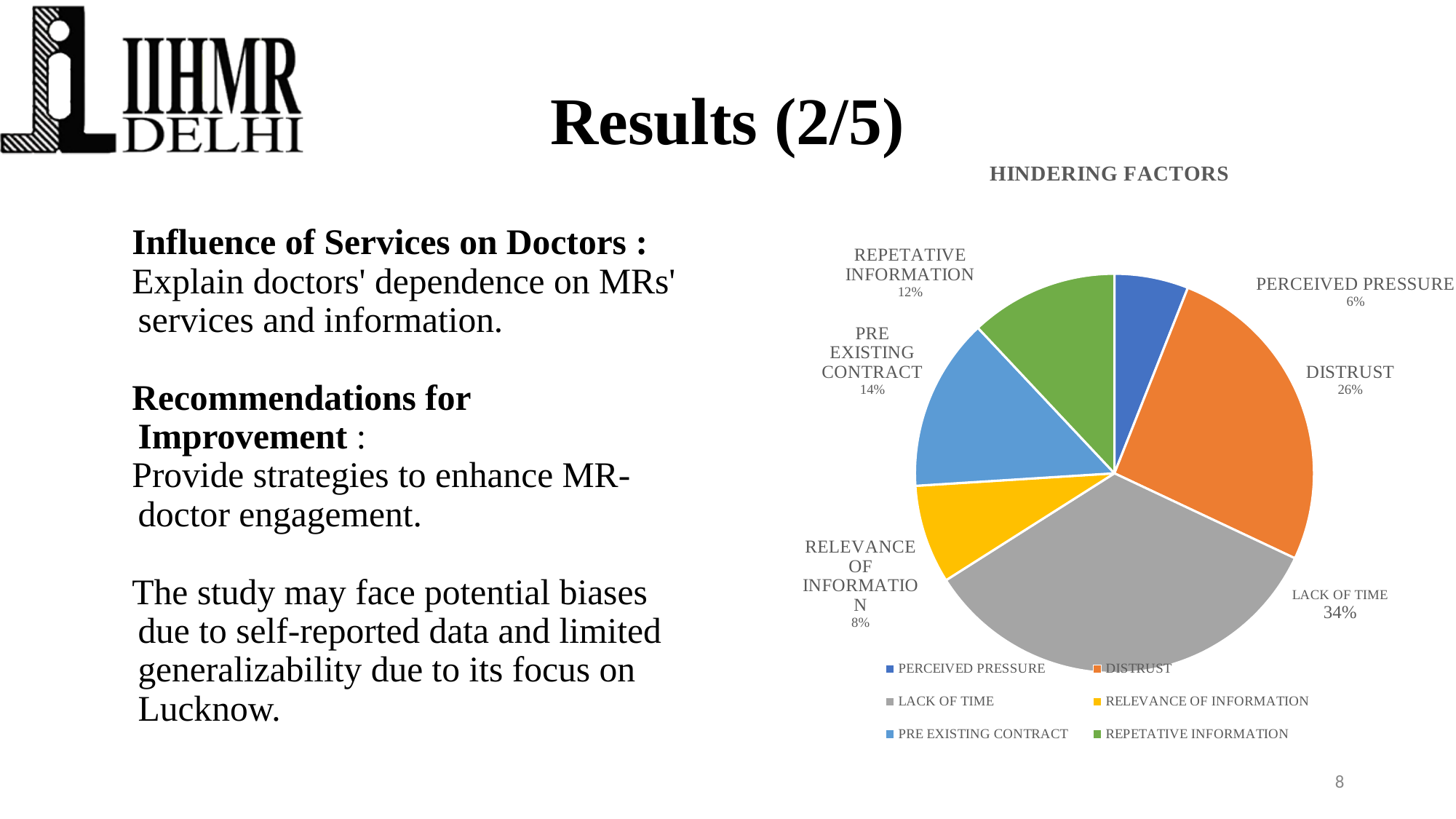
How many slices does the pie chart have? 6 What share of the pie does PERCEIVED PRESSURE represent? 6% What share of the pie does LACK OF TIME represent? 34% What share of the pie does DISTRUST represent? 26% What share of the pie does REPETATIVE INFORMATION represent? 12% Which hindering factor has the smallest share of the pie? PERCEIVED PRESSURE What share of the pie does PRE EXISTING CONTRACT represent? 14% Which hindering factor has the largest share of the pie? LACK OF TIME Which has a larger share, PRE EXISTING CONTRACT or RELEVANCE OF INFORMATION? PRE EXISTING CONTRACT What type of chart is shown on the slide? pie chart What is the title of the chart? HINDERING FACTORS What is the difference in percentage points between LACK OF TIME and DISTRUST? 8